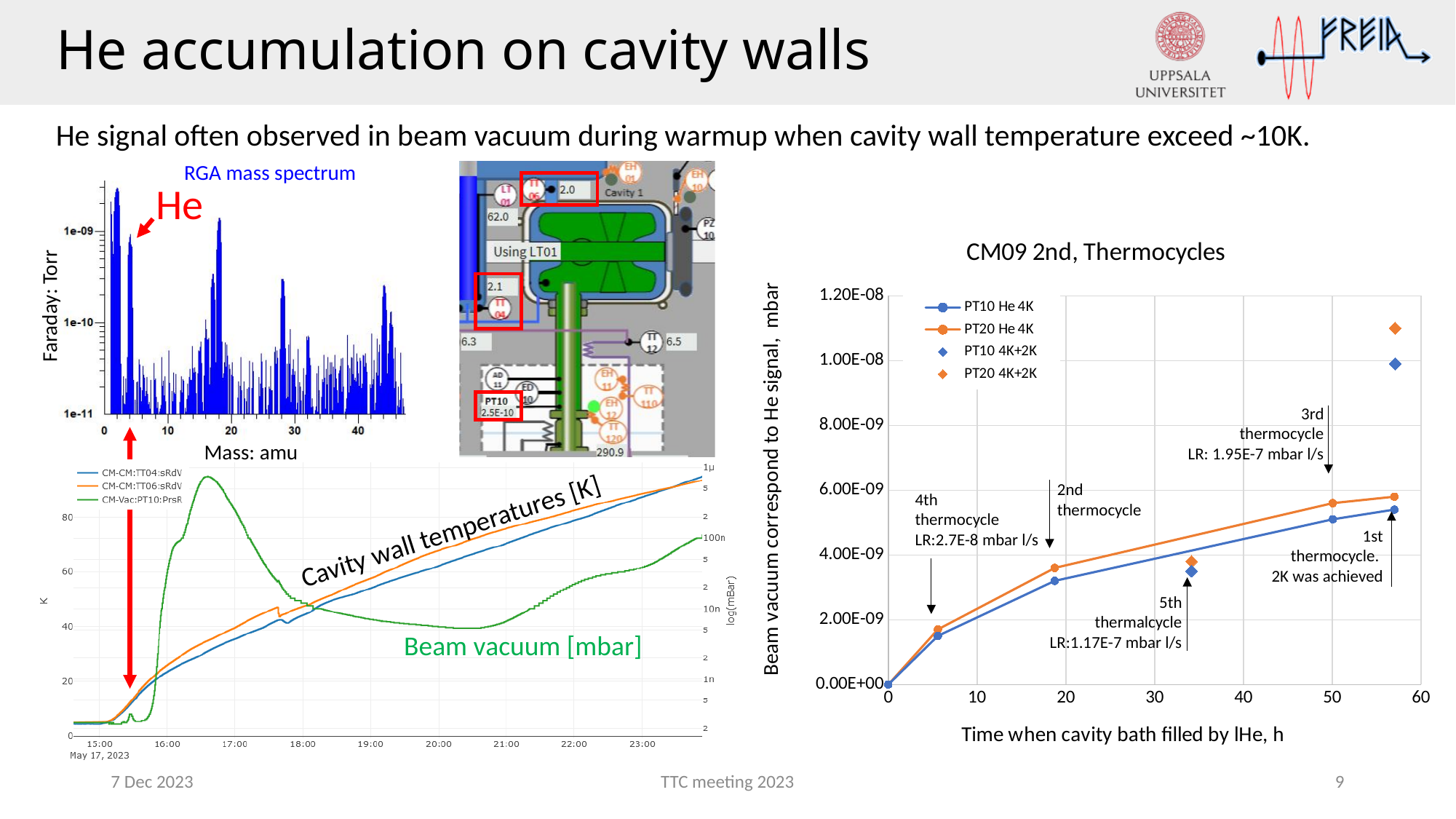
How many series does the legend of the CM09 2nd, Thermocycles chart list? 4 What is the x-axis title of the CM09 2nd, Thermocycles chart? Time when cavity bath filled by lHe, h On the CM09 2nd, Thermocycles chart, which series reaches the highest plotted value? PT20 4K+2K On the CM09 2nd, Thermocycles chart, is the PT20 4K+2K value at about 57 h greater or less than 1.00E-08? greater On the CM09 2nd, Thermocycles chart, at about 57 h, which is higher: PT20 4K+2K or PT10 4K+2K? PT20 4K+2K On the CM09 2nd, Thermocycles chart, does the PT20 He 4K series rise or fall as time increases? rises On the CM09 2nd, Thermocycles chart, how many data points are plotted on the PT10 He 4K line? 5 On the CM09 2nd, Thermocycles chart, at 50 h, which is higher: PT20 He 4K or PT10 He 4K? PT20 He 4K On the CM09 2nd, Thermocycles chart, is the PT10 He 4K value at 50 h greater or less than 6.00E-09? less On the CM09 2nd, Thermocycles chart, is the PT10 4K+2K value at about 34 h greater or less than 4.00E-09? less How many series does the legend of the bottom-left time-series chart (cavity wall temperatures and beam vacuum) list? 3 On the CM09 2nd, Thermocycles chart, what kind of chart is used to plot the PT10 He 4K and PT20 He 4K series? line chart